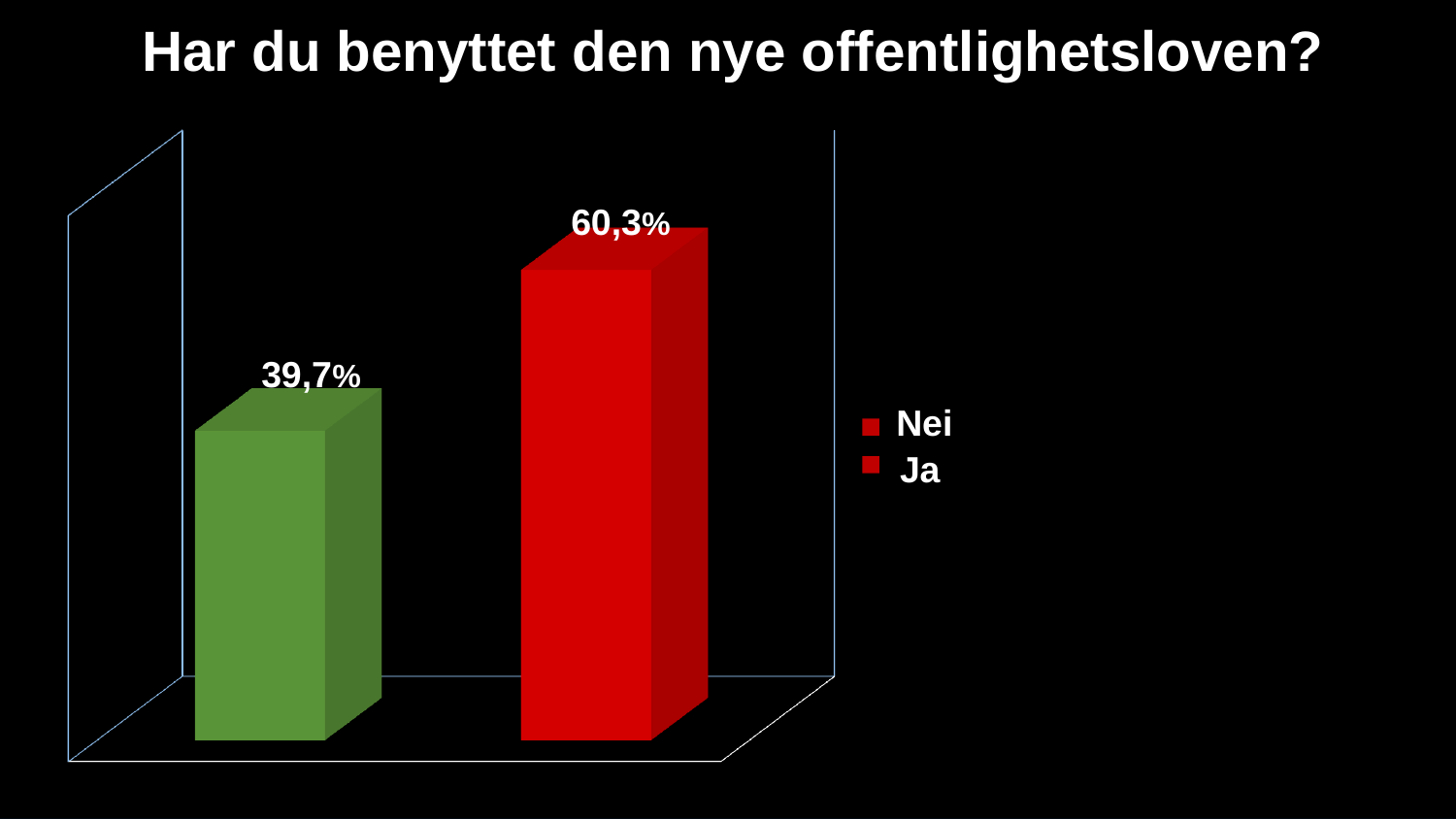
What value is printed on the green bar? 39,7% What is the title of the chart? Har du benyttet den nye offentlighetsloven? How many entries does the legend list? 2 What kind of chart is shown on the slide? bar chart Which bar is taller, the red bar or the green bar? the red bar What is the highest value shown in the chart? 60,3% How many bars are plotted in the chart? 2 What is the lowest value shown in the chart? 39,7% What is the difference between the value on the red bar and the value on the green bar? 20,6% What are the two entries listed in the legend? Nei and Ja What value is printed on the red bar? 60,3%